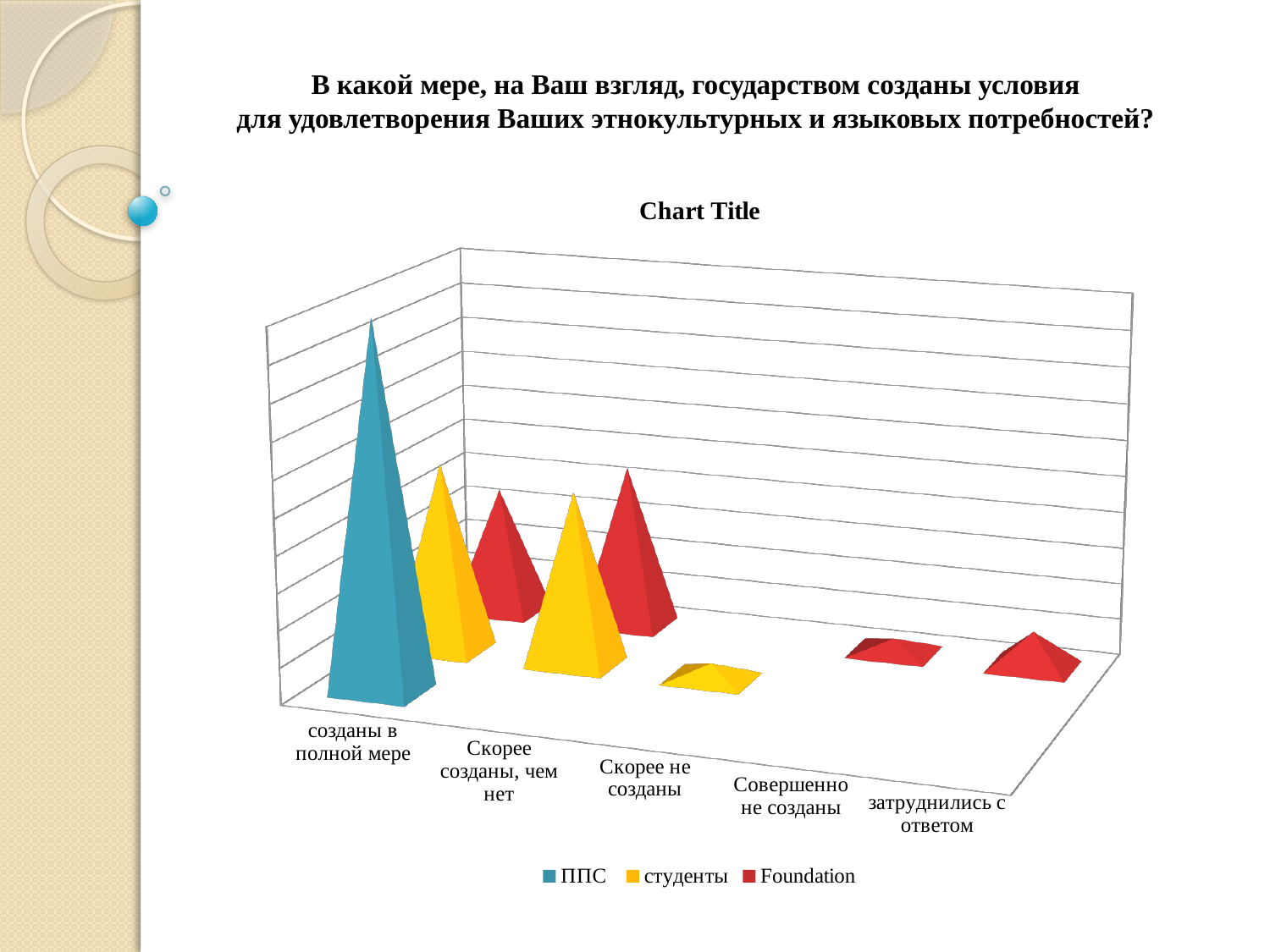
In the category 'созданы в полной мере', which is larger: the value for ППС or the value for студенты? ППС For the студенты series, which is larger: the value for 'созданы в полной мере' or the value for 'Скорее не созданы'? созданы в полной мере What colour represents the Foundation series in the chart? red Which series has the tallest bar in the whole chart? ППС How many series does the chart legend list? 3 Which category has the highest value for the ППС series? созданы в полной мере What kind of chart is shown on the slide? bar chart How many categories are shown on the x axis of the chart? 5 What are the three series names listed in the chart legend? ППС, студенты, Foundation